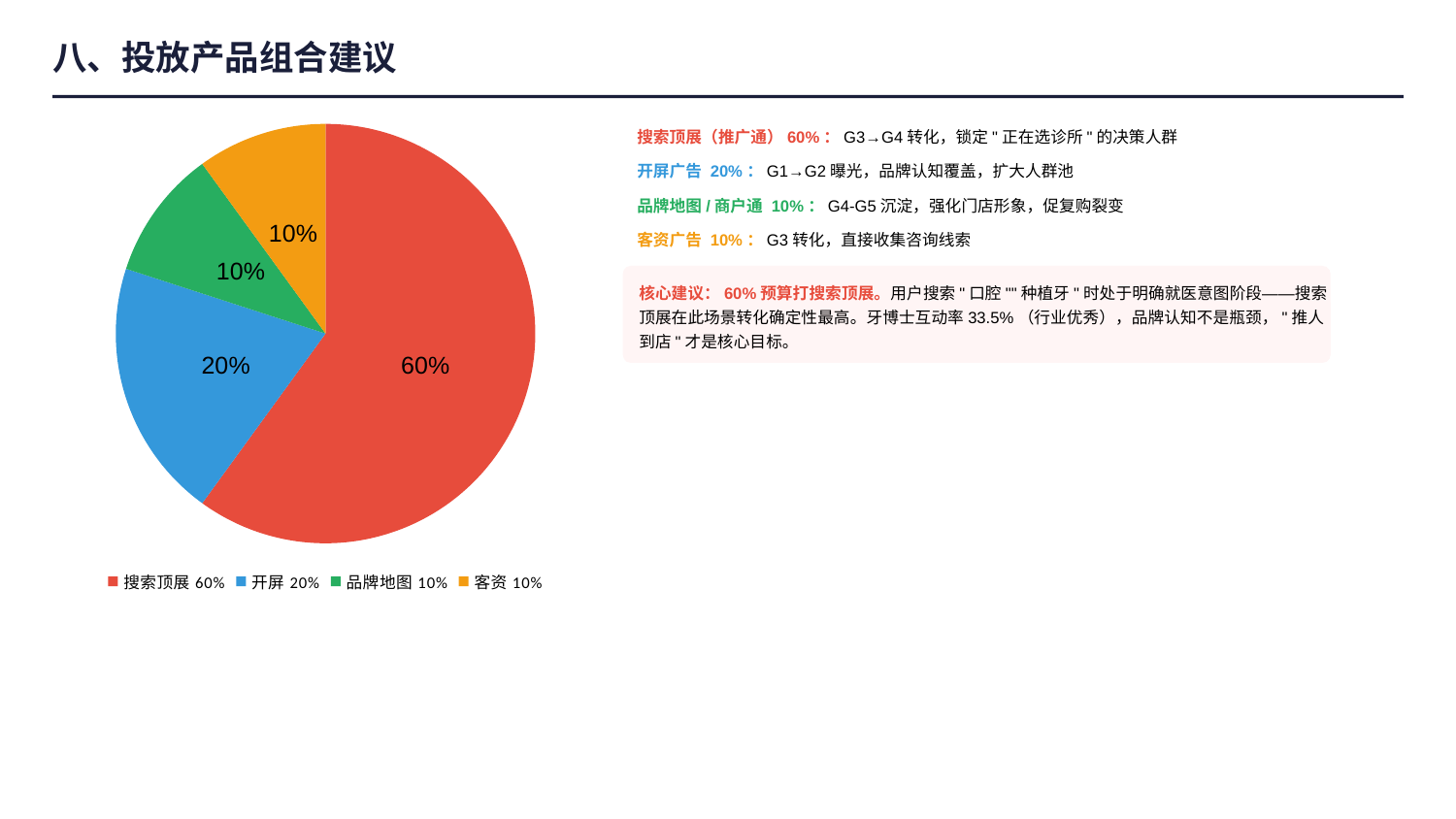
What colour is the 搜索顶展 slice in the pie chart? red What colour is the 开屏 slice in the pie chart? blue What is the difference between the shares of 搜索顶展 and 开屏? 40% Which category has the largest slice of the pie? 搜索顶展 What kind of chart is shown on the slide? pie chart What share of the pie does 开屏 take? 20% What share of the pie does 客资 take? 10% Which is larger, the share of 开屏 or the share of 客资? 开屏 What share of the pie does 品牌地图 take? 10% How many slices does the pie chart have? 4 How many entries does the legend list? 4